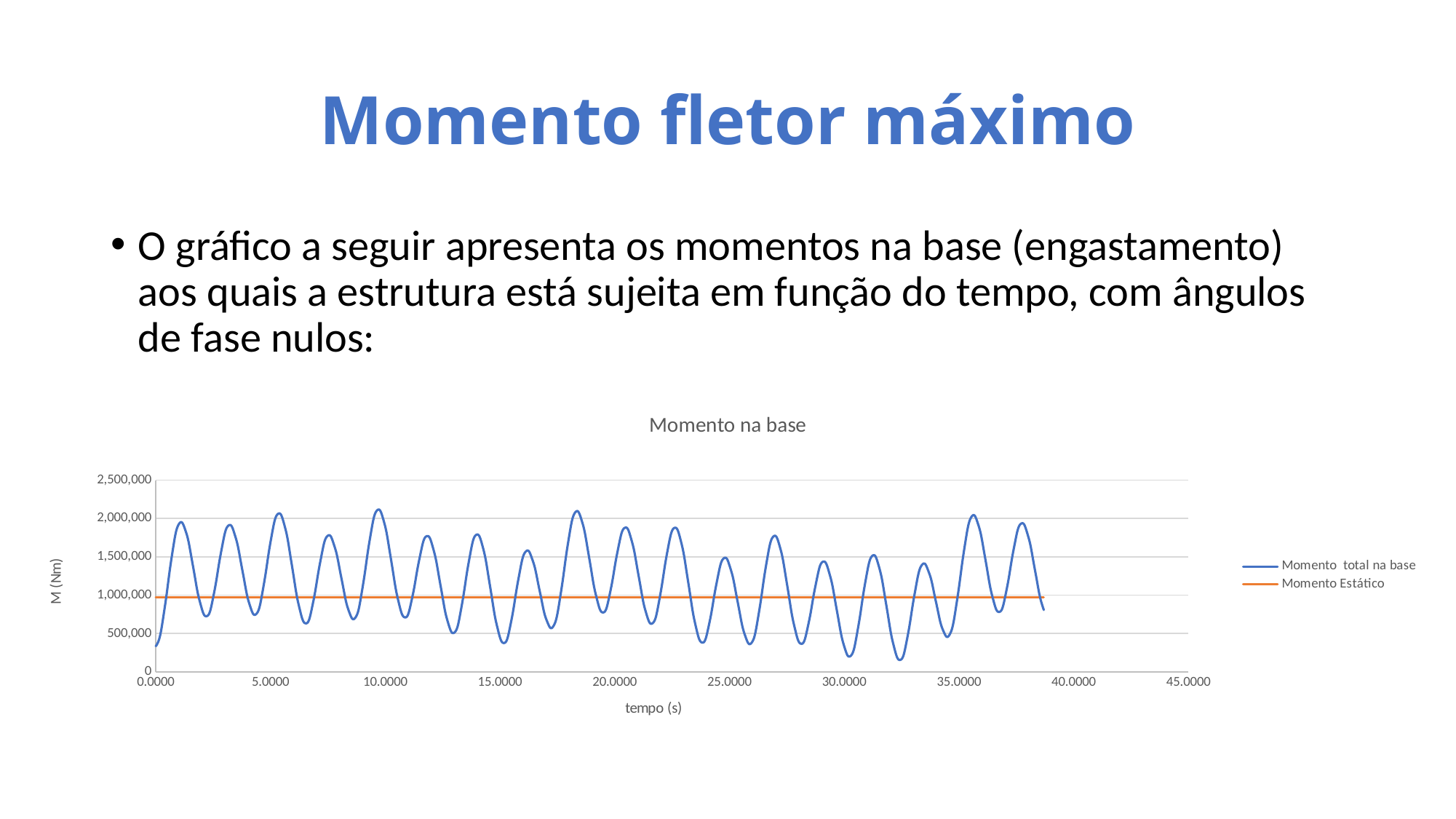
How many tick labels are shown on the x axis of the chart? 10 What kind of chart is shown on the slide? line chart Is the highest peak of Momento total na base greater or less than 2,000,000? greater How many series does the legend of the chart list? 2 Which series reaches the highest value on the chart? Momento total na base What is the label of the x axis of the chart? tempo (s) Does the Momento Estático series rise, fall, or stay constant along the x axis? stay constant What is the title of the chart? Momento na base Is the value of Momento Estático greater or less than 500,000? greater Is the lowest value of Momento total na base greater or less than 500,000? less At tempo 0.0000, which series has the larger value, Momento total na base or Momento Estático? Momento Estático